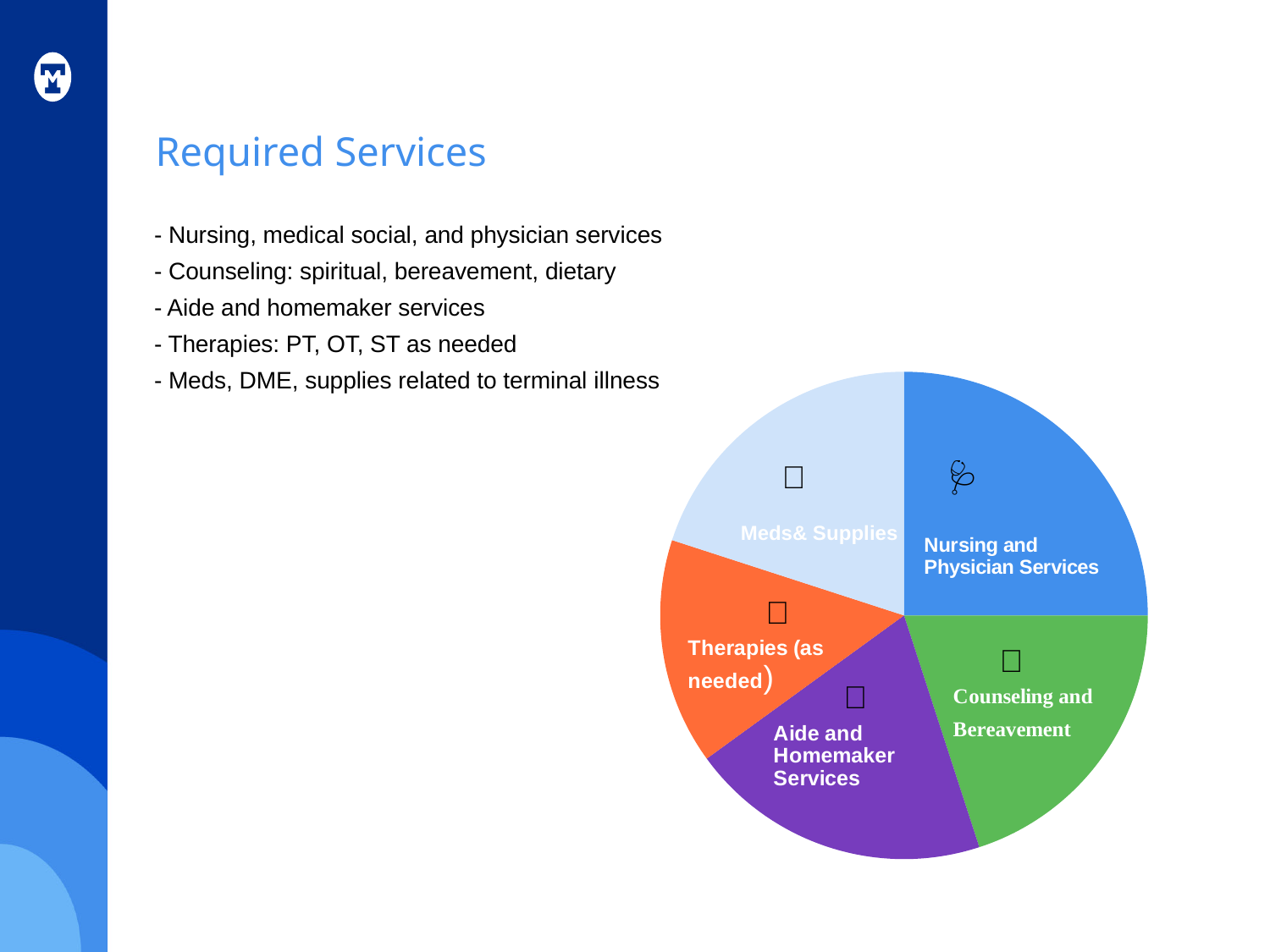
Which is larger in the pie chart: the Nursing and Physician Services slice or the Therapies (as needed) slice? Nursing and Physician Services Which slice of the pie chart is coloured orange? Therapies (as needed) How many slices does the pie chart have? 5 What kind of chart is shown on the slide? pie chart Which slice of the pie chart is the largest? Nursing and Physician Services What colour is the Counseling and Bereavement slice in the pie chart? green Which slice of the pie chart is the smallest? Therapies (as needed)